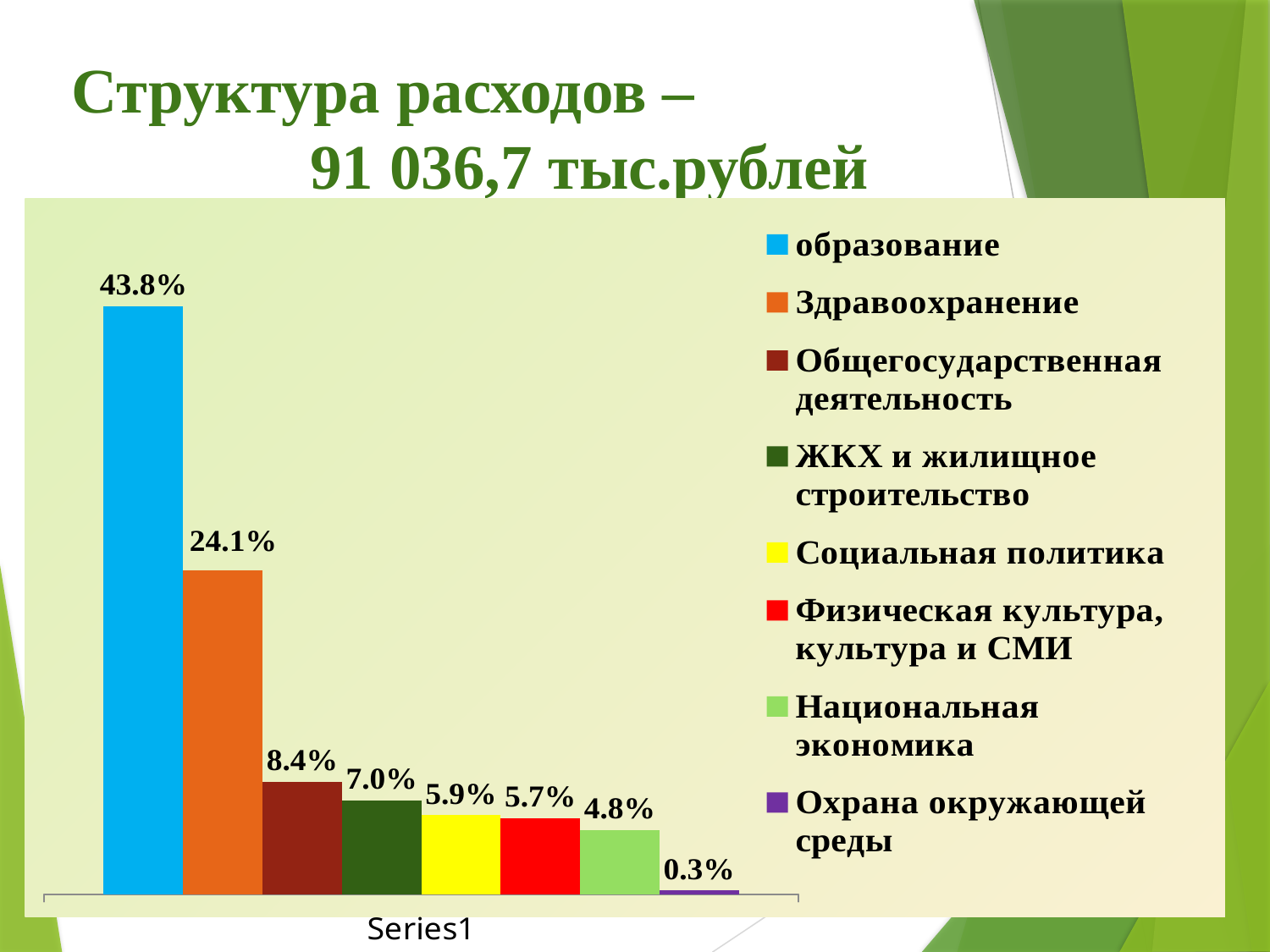
What share of expenditures goes to образование? 43.8% What is the value shown for Здравоохранение? 24.1% How many entries does the legend list? 8 Which expenditure item has the highest share? образование What is the value shown for Охрана окружающей среды? 0.3% Which expenditure item has the lowest share? Охрана окружающей среды What kind of chart is shown on the slide? bar chart What is the difference between the shares for образование and Здравоохранение? 19.7% Which is larger, the share for Социальная политика or the share for Национальная экономика? Социальная политика What is the value shown for ЖКХ и жилищное строительство? 7.0% What colour is the bar for Социальная политика? yellow What is the difference between the shares for Общегосударственная деятельность and Национальная экономика? 3.6%